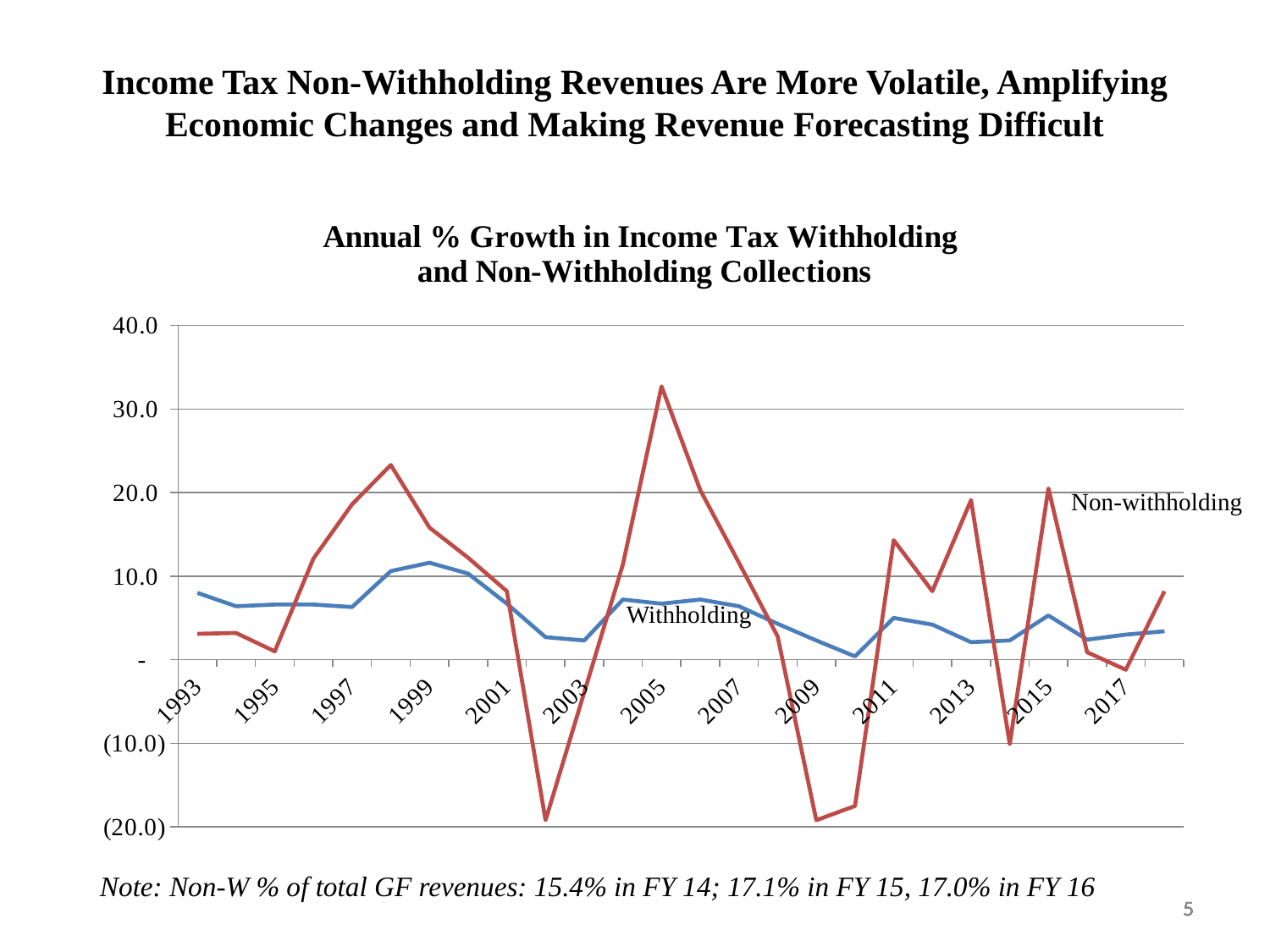
Is the Non-withholding value for 2005 greater or less than 30.0? greater In 2005, which series has the higher value, Withholding or Non-withholding? Non-withholding Does the Non-withholding series rise or fall between 2005 and 2009? fall Is the Non-withholding value for 1998 greater or less than 20.0? greater How many series are plotted on the chart? 2 In which year does the Non-withholding series reach its highest value? 2005 What is the title of the chart? Annual % Growth in Income Tax Withholding and Non-Withholding Collections What kind of chart is shown on the slide? line chart Which series does the red line represent? Non-withholding Is the Withholding value for 1999 greater or less than 10.0? greater In 2009, which series has the higher value, Withholding or Non-withholding? Withholding